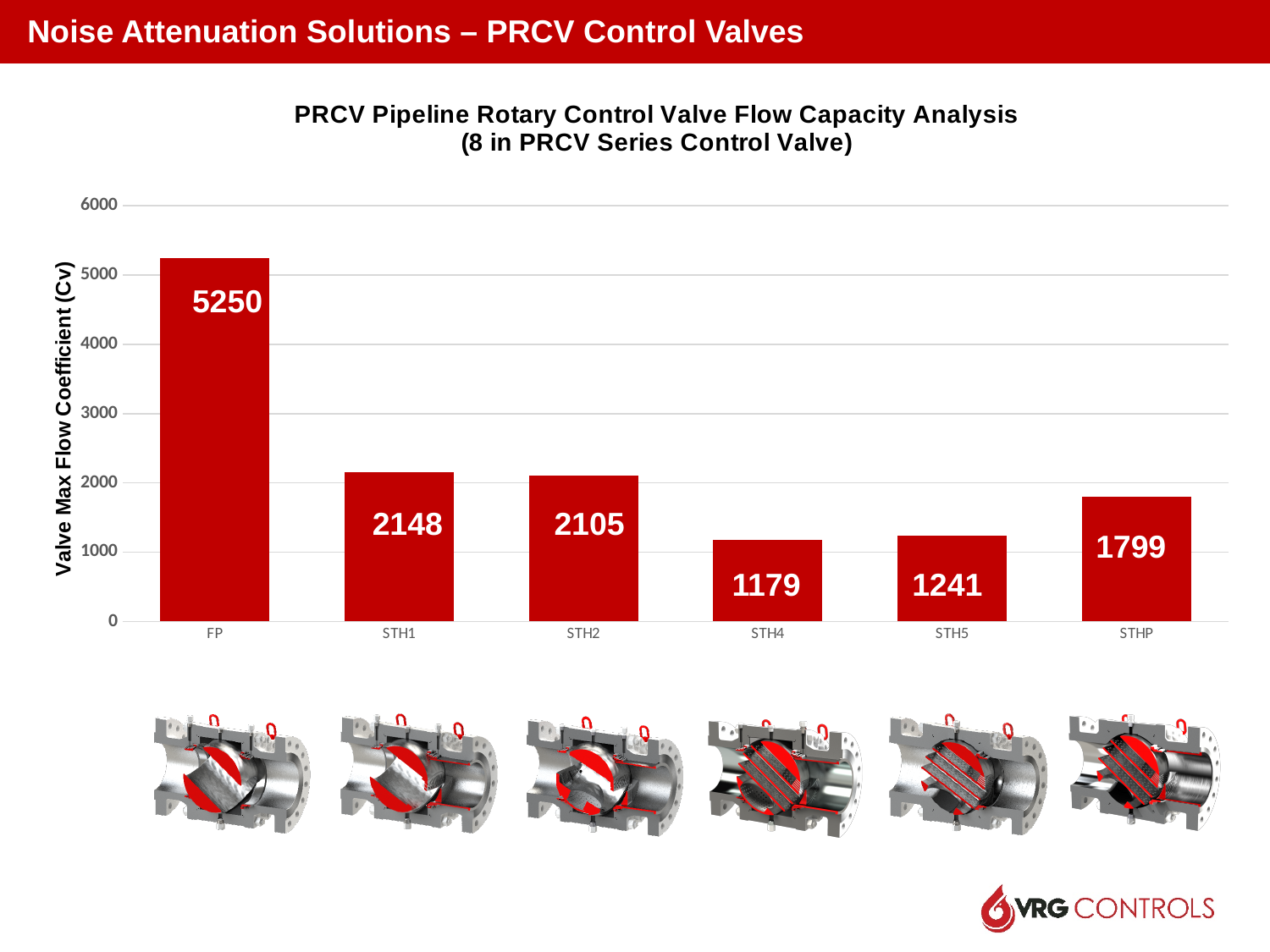
What is the difference between the values for FP and STH1? 3102 How many categories are shown on the x axis? 6 Which has a larger Valve Max Flow Coefficient, STH2 or STHP? STH2 Which category has the lowest Valve Max Flow Coefficient? STH4 Is the value for STH1 greater or less than 2000? greater What kind of chart is shown on the slide? bar chart Which category has the highest Valve Max Flow Coefficient? FP What is the Valve Max Flow Coefficient (Cv) for FP? 5250 What is the label of the y axis? Valve Max Flow Coefficient (Cv) What is the difference between the values for STH5 and STH4? 62 What is the Valve Max Flow Coefficient (Cv) for STHP? 1799 What is the Valve Max Flow Coefficient (Cv) for STH4? 1179